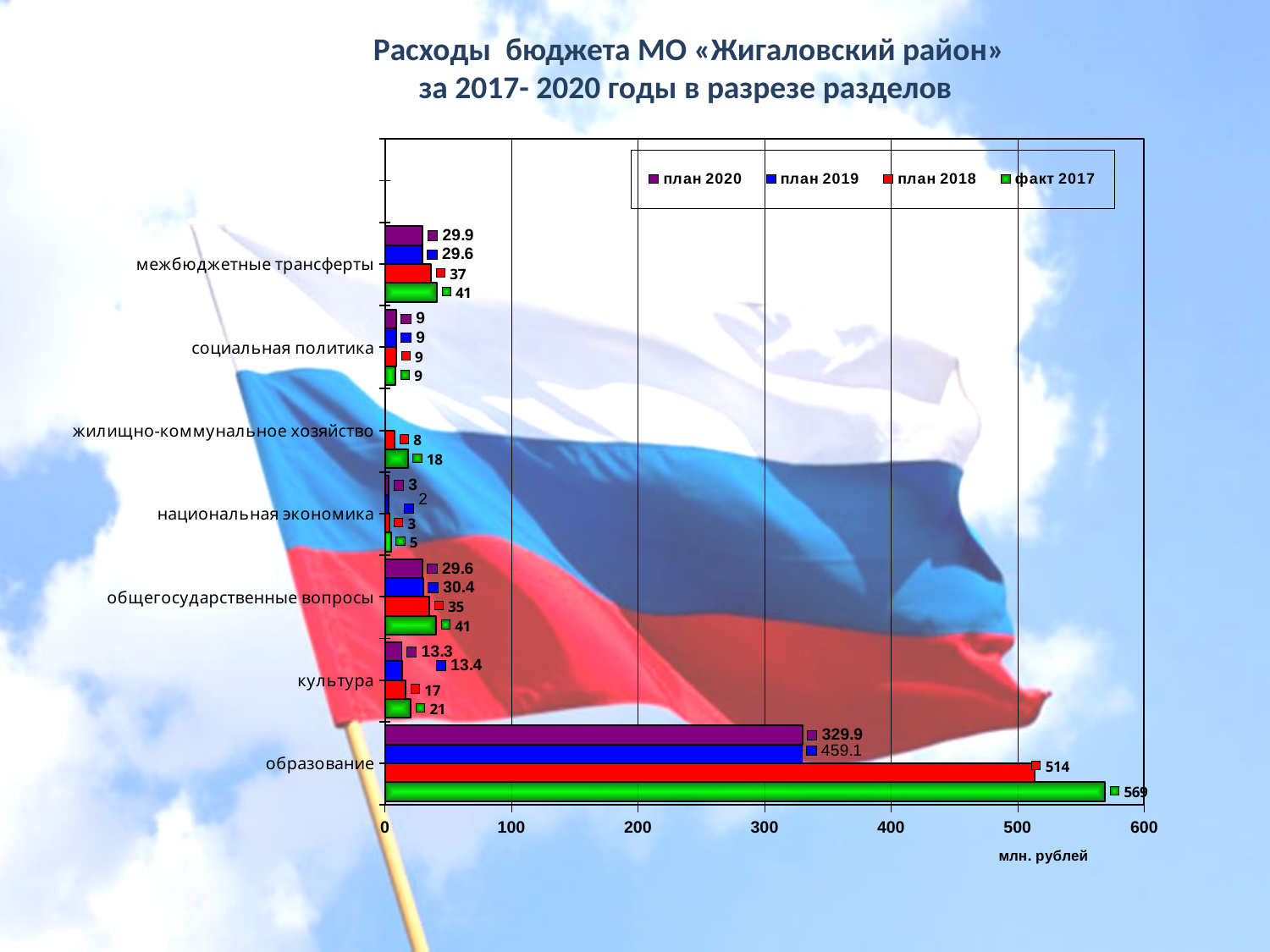
How many series does the legend list? 4 What is the факт 2017 value for образование? 569 Which category has the lowest план 2019 value? национальная экономика What type of chart is shown on the slide? bar chart Which is larger for межбюджетные трансферты: the план 2018 value or the факт 2017 value? факт 2017 What is the план 2018 value for общегосударственные вопросы? 35 How many categories (budget sections) are shown on the chart? 7 What unit is shown on the x axis of the chart? млн. рублей Which category has the highest факт 2017 value? образование What is the difference between the план 2018 and план 2020 values for образование? 184.1 What is the план 2020 value for образование? 329.9 What is the план 2019 value for культура? 13.4